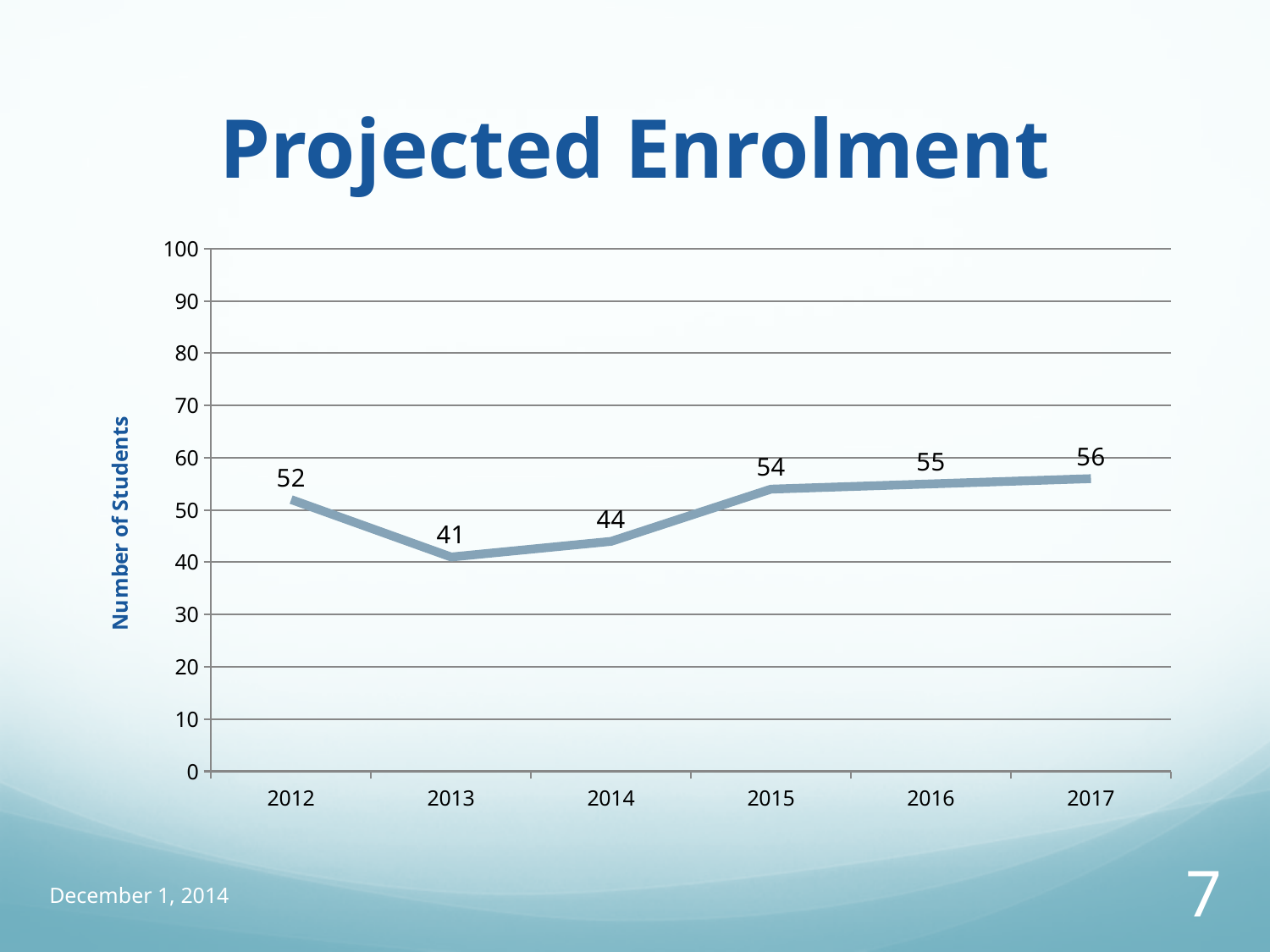
Is the value for 2015 greater or less than 50? greater What is the value plotted for 2012? 52 What is the label on the vertical axis of the chart? Number of Students By how much does the enrolment change from 2012 to 2013? 11 What kind of chart is shown on the slide? Line chart What is the difference between the enrolment in 2017 and the enrolment in 2013? 15 Which year has the highest projected enrolment? 2017 Which year has a larger enrolment, 2012 or 2014? 2012 How many years are plotted on the chart? 6 What is the projected enrolment for 2013? 41 Which year has the lowest projected enrolment? 2013 What is the number of students shown for 2016? 55